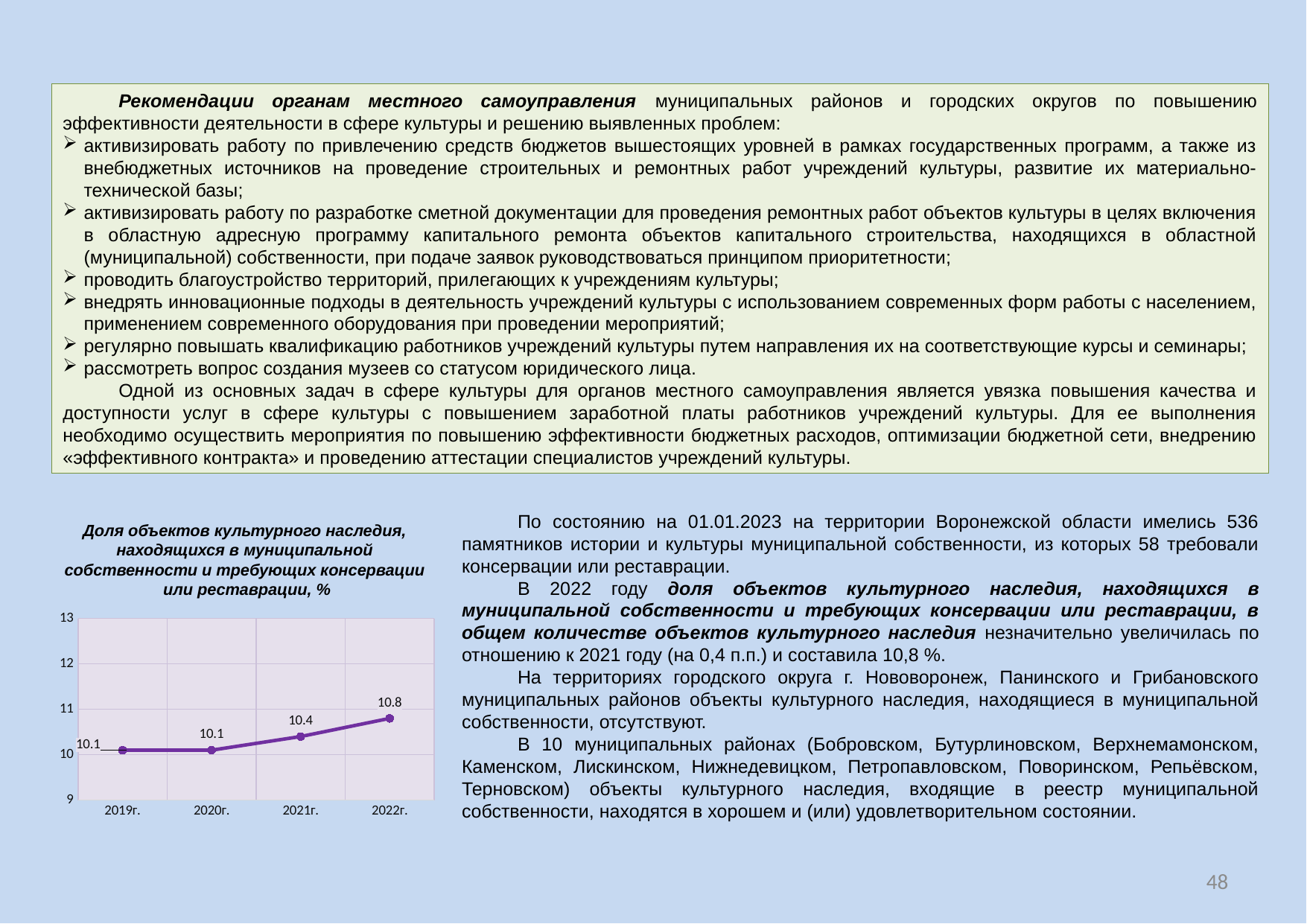
Is the value for 2022г. greater or less than 11? less Which is larger, the value for 2021г. or the value for 2020г.? 2021г. What is the difference between the values for 2022г. and 2021г.? 0.4 Which year has the highest value on the chart? 2022г. What is the difference between the values for 2022г. and 2019г.? 0.7 Do the values rise or fall from 2020г. to 2022г.? rise What unit is indicated in the chart title? % What kind of chart is shown on the slide? line chart What is the value for 2021г. on the chart? 10.4 How many years are plotted on the chart? 4 What is the value for 2019г. on the chart? 10.1 What is the value for 2022г. on the chart? 10.8